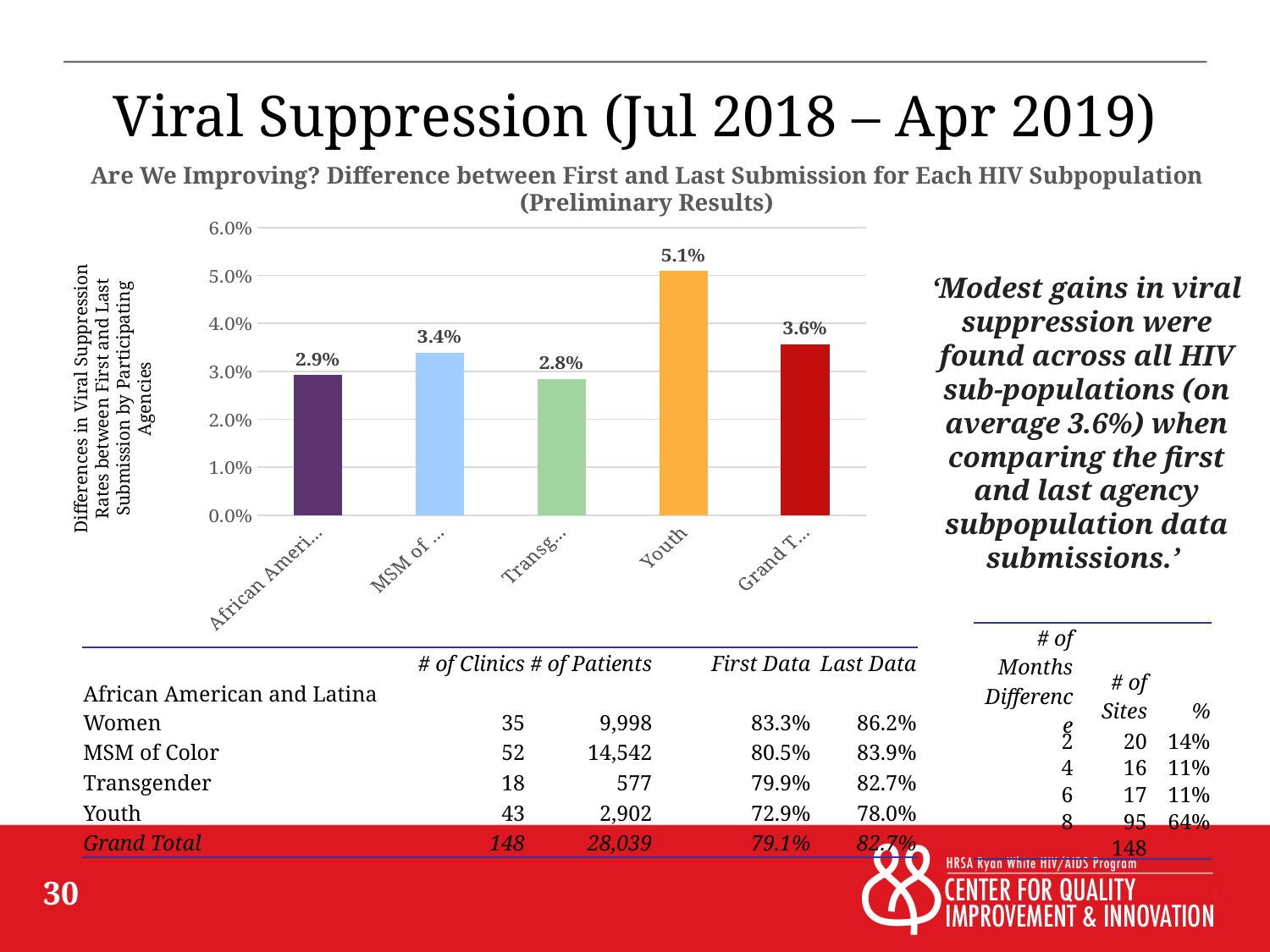
How many bars are shown in the chart? 5 What is the value for the Transgender ("Transg...") bar in the chart? 2.8% What kind of chart is shown on the slide? Bar chart Which category has the lowest value in the bar chart? Transgender ("Transg...") Is the value for Youth greater or less than 4.0%? greater What is the value for the Grand Total ("Grand T...") bar in the chart? 3.6% Which category has the highest value in the bar chart? Youth What is the value for the MSM ("MSM of ...") bar in the chart? 3.4% What is the difference between the Youth value and the Grand Total value in the chart? 1.5% What is the value for Youth in the bar chart? 5.1% Which is larger in the chart: the MSM bar or the African American bar? MSM What is the difference between the Youth value and the Transgender value in the chart? 2.3%